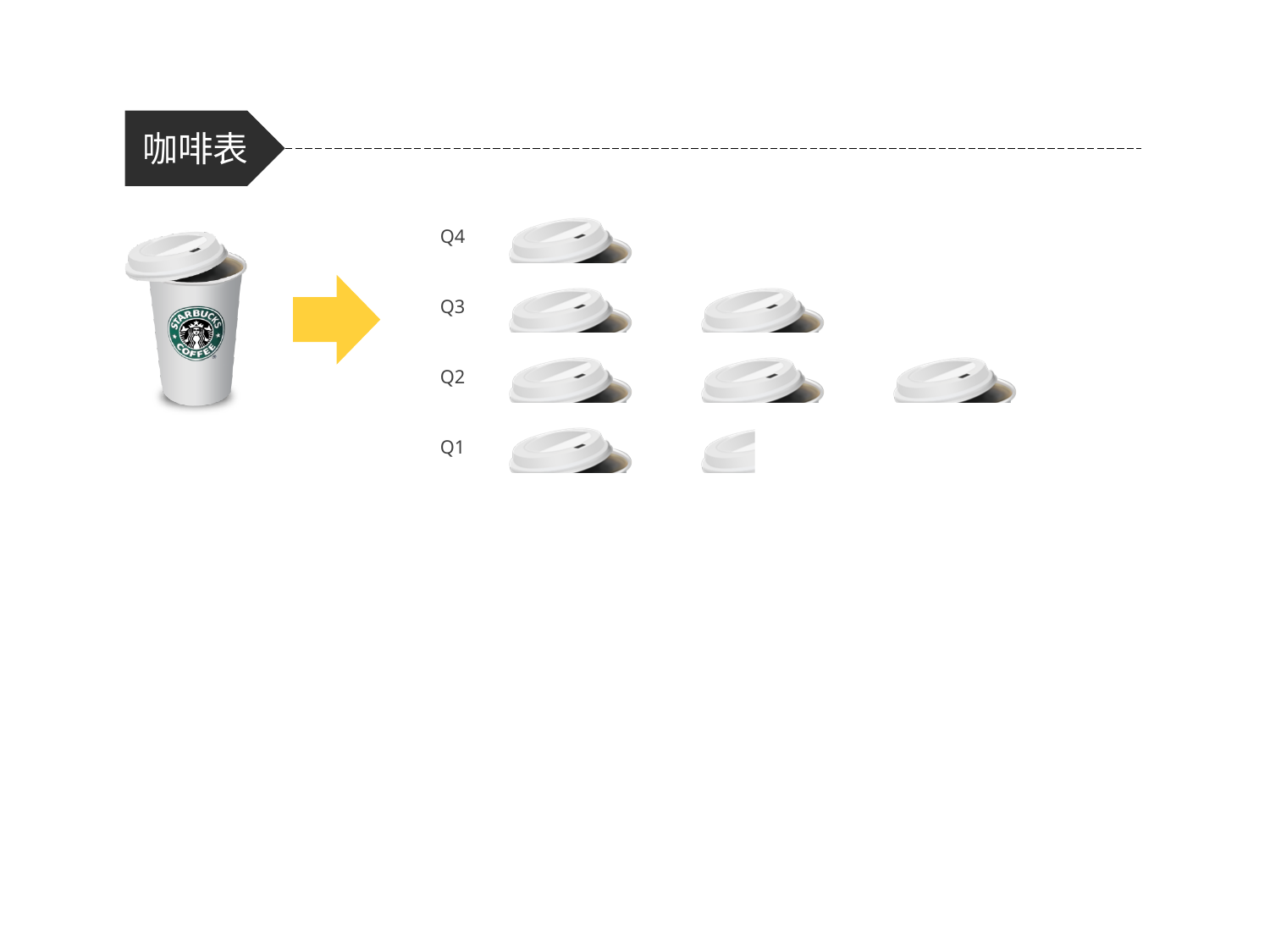
How many categories does the chart show? 4 Which category has the lowest value in the chart? Q4 What is the title of the chart? 咖啡表 Which category is listed at the top of the chart? Q4 Which category has the highest value in the chart? Q2 Which is larger, the value for Q3 or the value for Q4? Q3 What icon is used to represent the values in the chart? Coffee cups Which is larger, the value for Q2 or the value for Q1? Q2 What kind of chart is shown on the slide? Bar chart (pictograph with coffee cup icons) Which is larger, the value for Q3 or the value for Q1? Q3